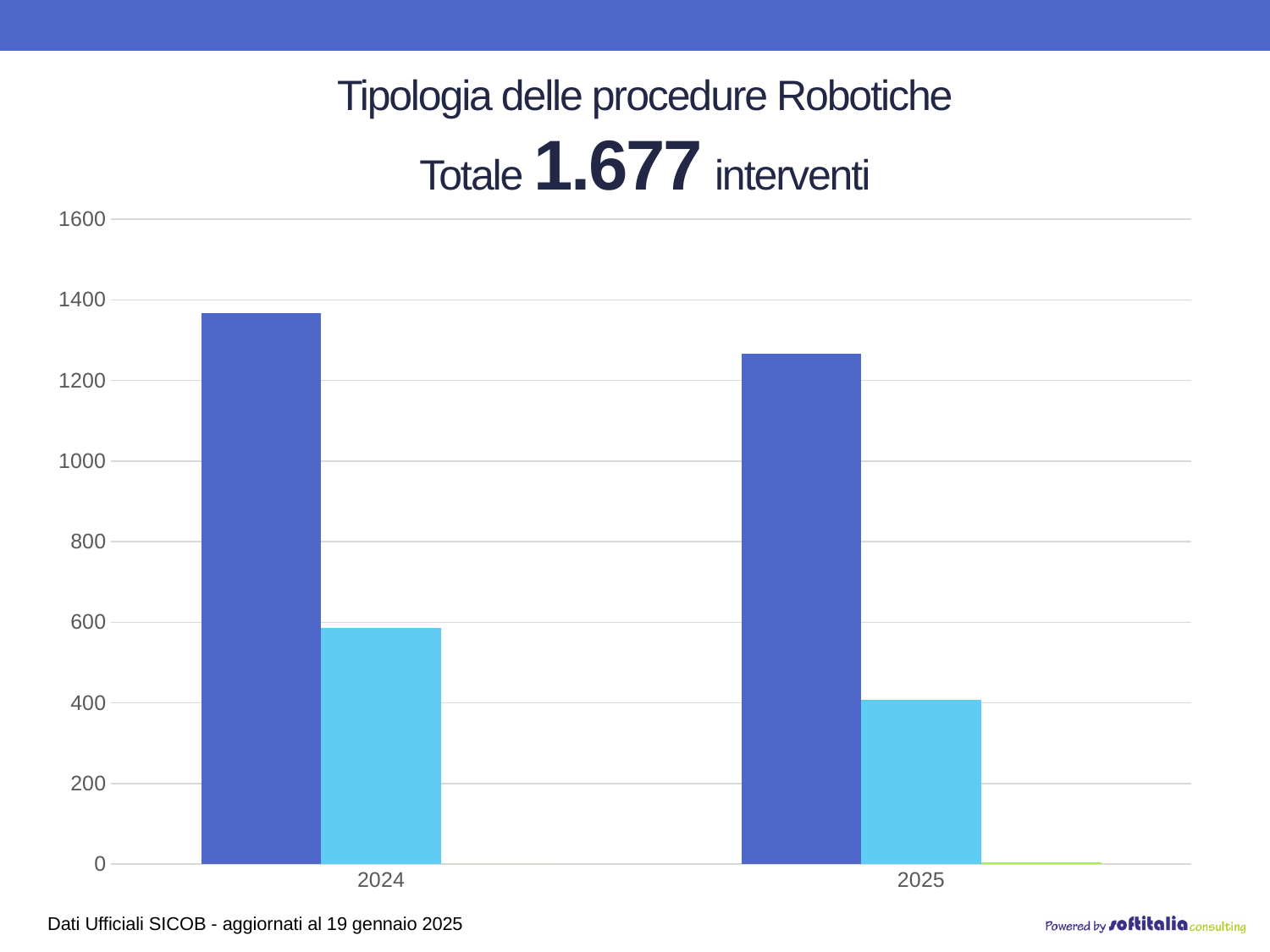
Is the value of the dark blue bar for 2024 greater or less than 1200? greater What kind of chart is shown on the slide? bar chart Is the value of the light blue bar for 2025 greater or less than 600? less In 2025, which bar is taller, the dark blue one or the light blue one? the dark blue one Is the value of the light blue bar for 2024 greater or less than 400? greater Which year has the taller light blue bar, 2024 or 2025? 2024 What is the title of the chart? Tipologia delle procedure Robotiche Totale 1.677 interventi Which year has the taller dark blue bar, 2024 or 2025? 2024 What are the categories on the x axis? 2024 and 2025 Do the dark blue bars rise or fall from 2024 to 2025? fall How many categories are shown on the x axis? 2